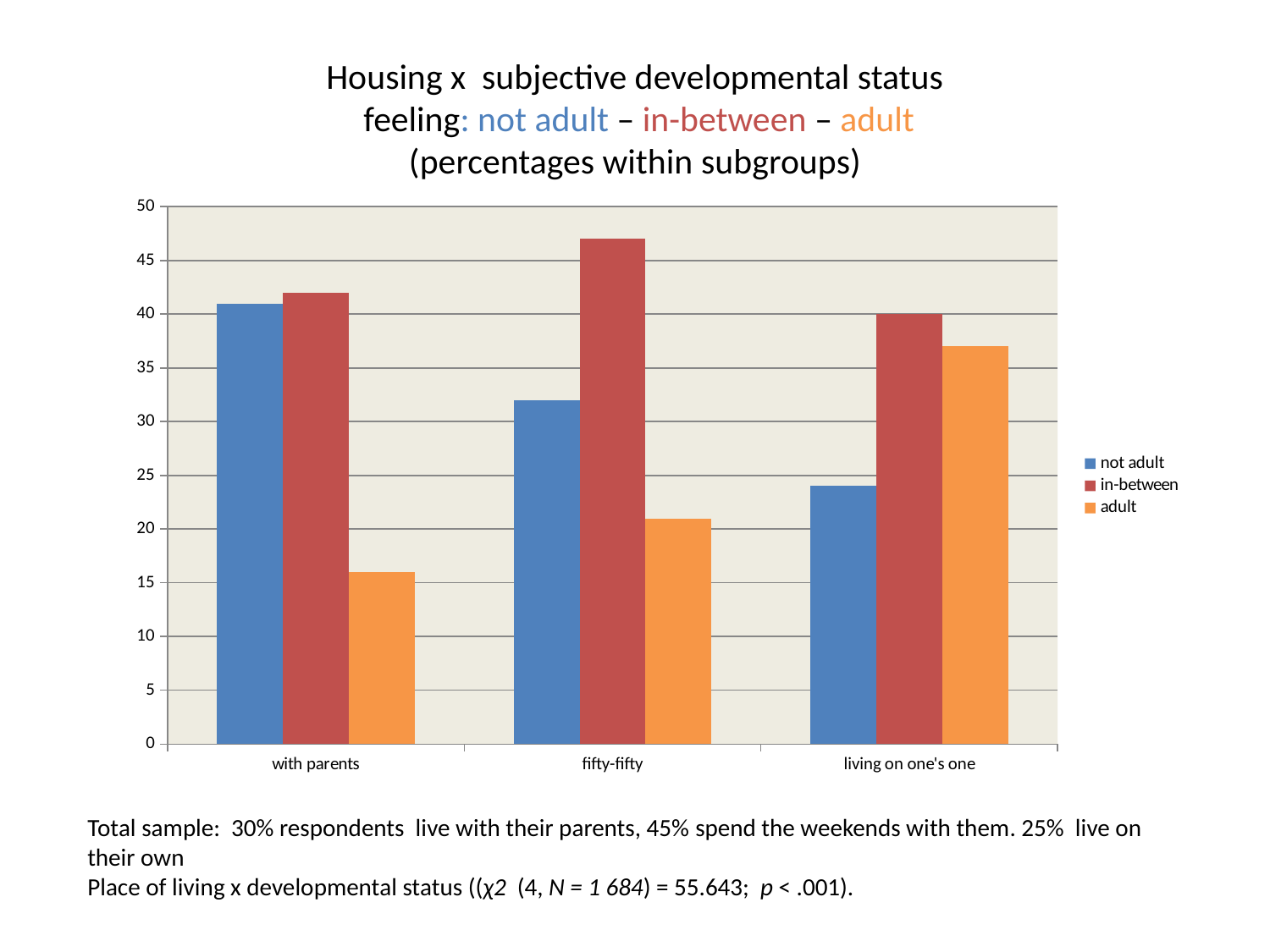
How many series does the legend list? 3 For fifty-fifty, which is larger: the not adult bar or the in-between bar? in-between How many housing categories are shown on the x axis? 3 Which colour represents the adult series in the legend? orange What kind of chart is shown on the slide? bar chart Which housing category has the highest adult bar? living on one's one Is the adult value for with parents greater or less than 20? less Is the in-between value for fifty-fifty greater or less than 45? greater Which housing category has the highest in-between bar? fifty-fifty Is the not adult value for living on one's one greater or less than 30? less Which housing category has the lowest adult bar? with parents Which housing category has the lowest not adult bar? living on one's one